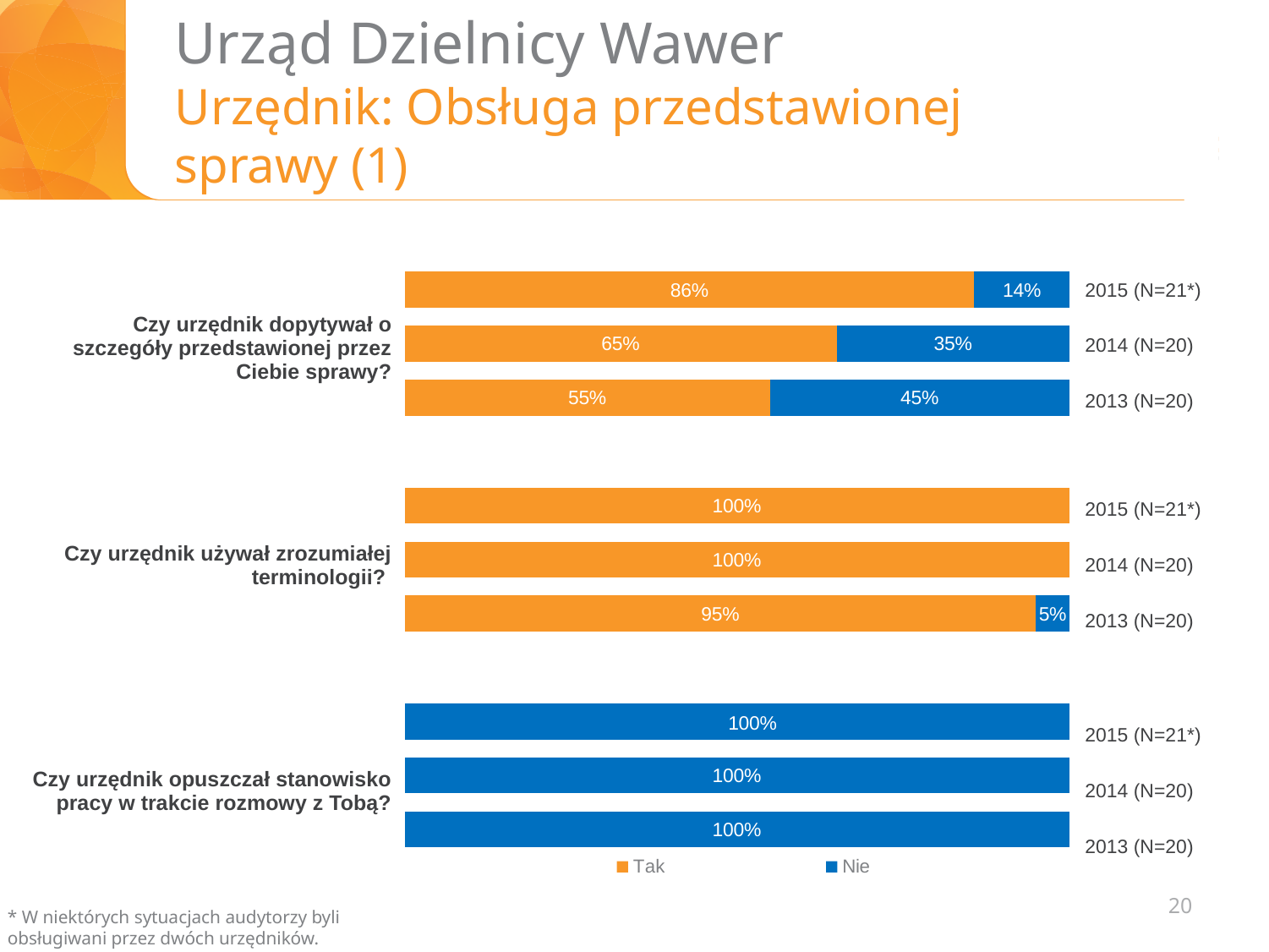
For the question "Czy urzędnik opuszczał stanowisko pracy w trakcie rozmowy z Tobą?", what percentage answered "Nie" in 2015 (N=21*)? 100% For the question "Czy urzędnik dopytywał o szczegóły przedstawionej przez Ciebie sprawy?", what percentage answered "Nie" in 2014 (N=20)? 35% For the question "Czy urzędnik dopytywał o szczegóły przedstawionej przez Ciebie sprawy?", in which year was the "Tak" share lowest? 2013 (N=20) For the question "Czy urzędnik dopytywał o szczegóły przedstawionej przez Ciebie sprawy?", what is the difference in percentage points between the "Tak" share in 2015 and in 2013? 31 For the question "Czy urzędnik dopytywał o szczegóły przedstawionej przez Ciebie sprawy?", which is larger in 2014: the "Tak" share or the "Nie" share? Tak For the question "Czy urzędnik używał zrozumiałej terminologii?", what percentage answered "Nie" in 2013 (N=20)? 5% How many series does the legend list on this slide? 2 What kind of chart is shown on this slide? stacked bar chart For the question "Czy urzędnik dopytywał o szczegóły przedstawionej przez Ciebie sprawy?", does the "Tak" share rise or fall from 2013 to 2015? rise For the question "Czy urzędnik dopytywał o szczegóły przedstawionej przez Ciebie sprawy?", what percentage answered "Tak" in 2015 (N=21*)? 86% For the question "Czy urzędnik dopytywał o szczegóły przedstawionej przez Ciebie sprawy?", what percentage answered "Tak" in 2013 (N=20)? 55% For the question "Czy urzędnik dopytywał o szczegóły przedstawionej przez Ciebie sprawy?", in which year was the "Tak" share highest? 2015 (N=21*)